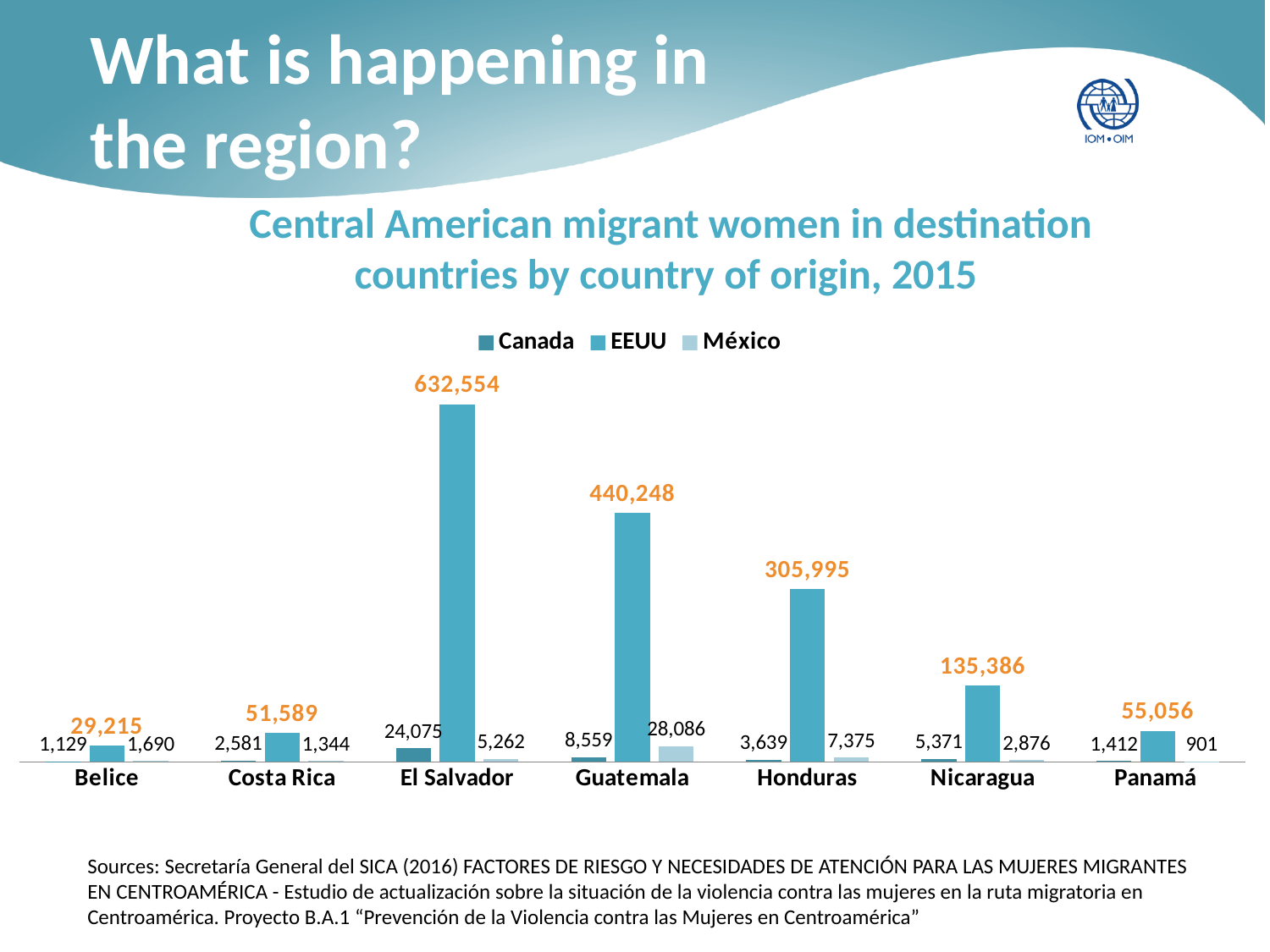
Which country of origin has the highest EEUU value? El Salvador What is the difference between the EEUU values for Costa Rica and Belice? 22,374 What is the México value for Honduras? 7,375 Which is larger, the Canada value for El Salvador or the México value for Guatemala? México value for Guatemala What is the Canada value for Guatemala? 8,559 What is the title of the chart? Central American migrant women in destination countries by country of origin, 2015 What kind of chart is shown on the slide? Bar chart What is the EEUU value for El Salvador? 632,554 How many series does the legend list? 3 Which country of origin has the lowest México value? Panamá How many countries of origin are shown on the x axis? 7 What is the difference between the EEUU values for Guatemala and Honduras? 134,253